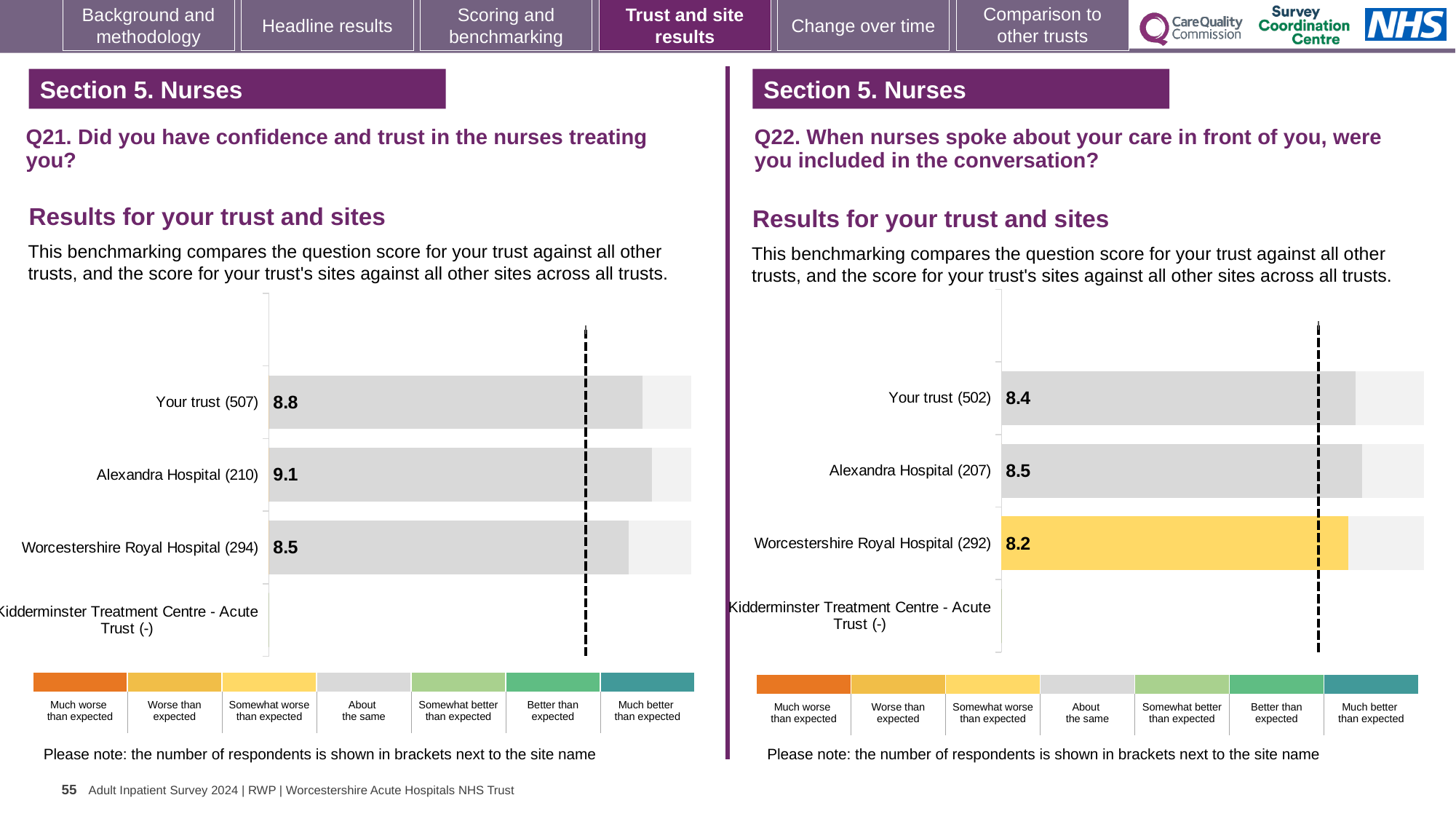
On the Q22 chart (right), what is the difference between the scores for Alexandra Hospital (207) and Your trust (502)? 0.1 On the Q22 chart (right), what is the score for Your trust (502)? 8.4 What type of chart is used on the Q22 chart (right)? Bar chart On the Q21 chart (left), which site or trust has the highest score? Alexandra Hospital (210) On the Q22 chart (right), which site or trust has the lowest score among those with a value shown? Worcestershire Royal Hospital (292) On the Q22 chart (right), which has the larger score: Alexandra Hospital (207) or Worcestershire Royal Hospital (292)? Alexandra Hospital (207) On the Q21 chart (left), what is the score for Alexandra Hospital (210)? 9.1 On the Q21 chart (left), what is the difference between the scores for Alexandra Hospital (210) and Worcestershire Royal Hospital (294)? 0.6 On the Q21 chart (left), what is the score for Your trust (507)? 8.8 How many categories (rows) are listed on the Q21 chart (left)? 4 On the Q22 chart (right), what is the score for Worcestershire Royal Hospital (292)? 8.2 On the Q22 chart (right), which bar is coloured yellow rather than grey? Worcestershire Royal Hospital (292)